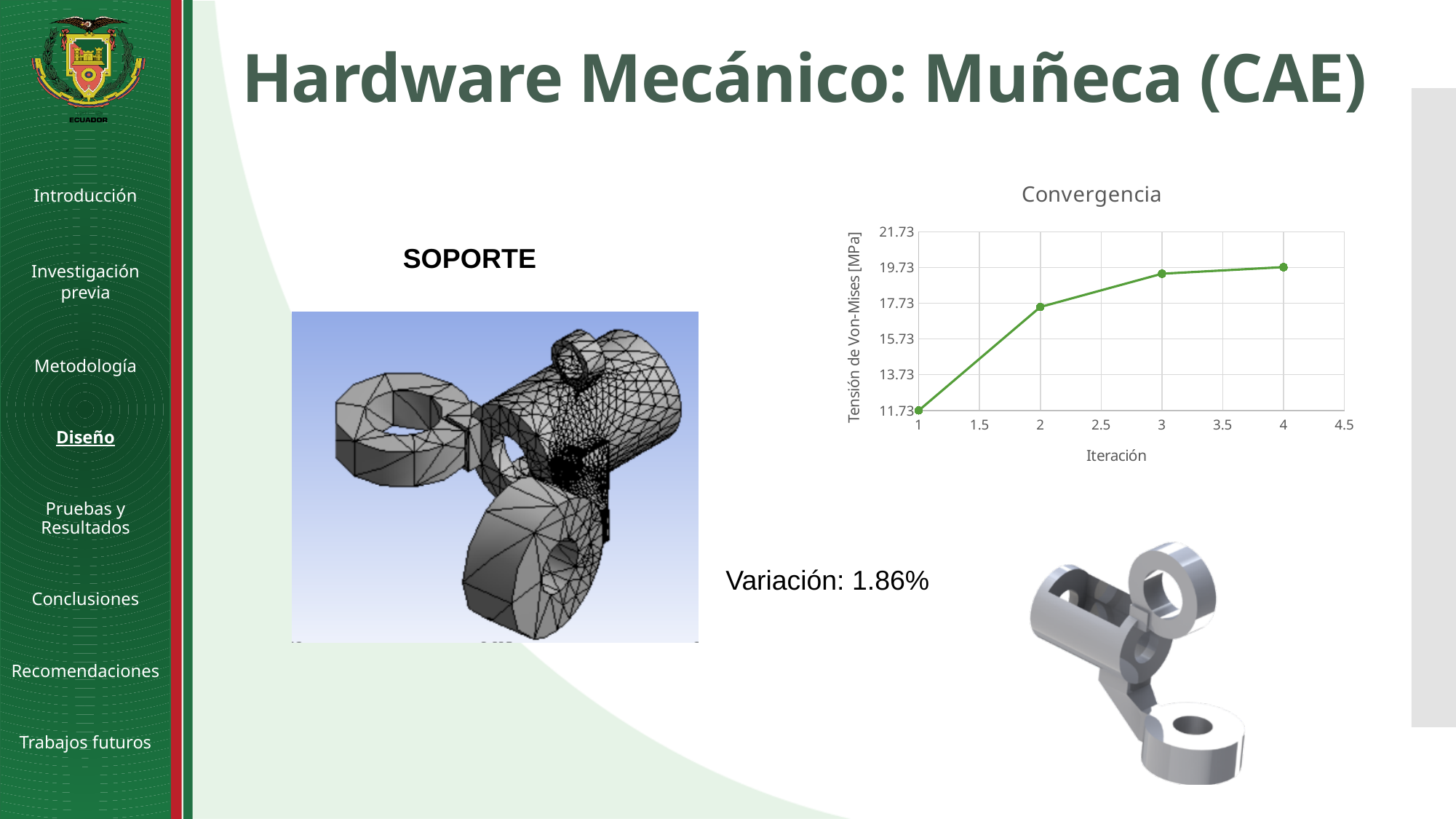
What is the title of the chart on the slide? Convergencia In the 'Convergencia' chart, which iteration has the lowest Von-Mises stress? 1 In the 'Convergencia' chart, which iteration has the highest Von-Mises stress? 4 In the 'Convergencia' chart, do the values rise or fall as the iteration increases? rise In the 'Convergencia' chart, is the value at iteration 1 greater or less than 13.73? less How many data points are plotted in the 'Convergencia' chart? 4 In the 'Convergencia' chart, which has a larger value: iteration 2 or iteration 3? iteration 3 What is the label of the y axis in the 'Convergencia' chart? Tensión de Von-Mises [MPa] In the 'Convergencia' chart, is the value at iteration 3 greater or less than 17.73? greater What kind of chart is the 'Convergencia' chart? line chart In the 'Convergencia' chart, is the value at iteration 2 greater or less than 15.73? greater In the 'Convergencia' chart, what is the Von-Mises stress at iteration 1? 11.73